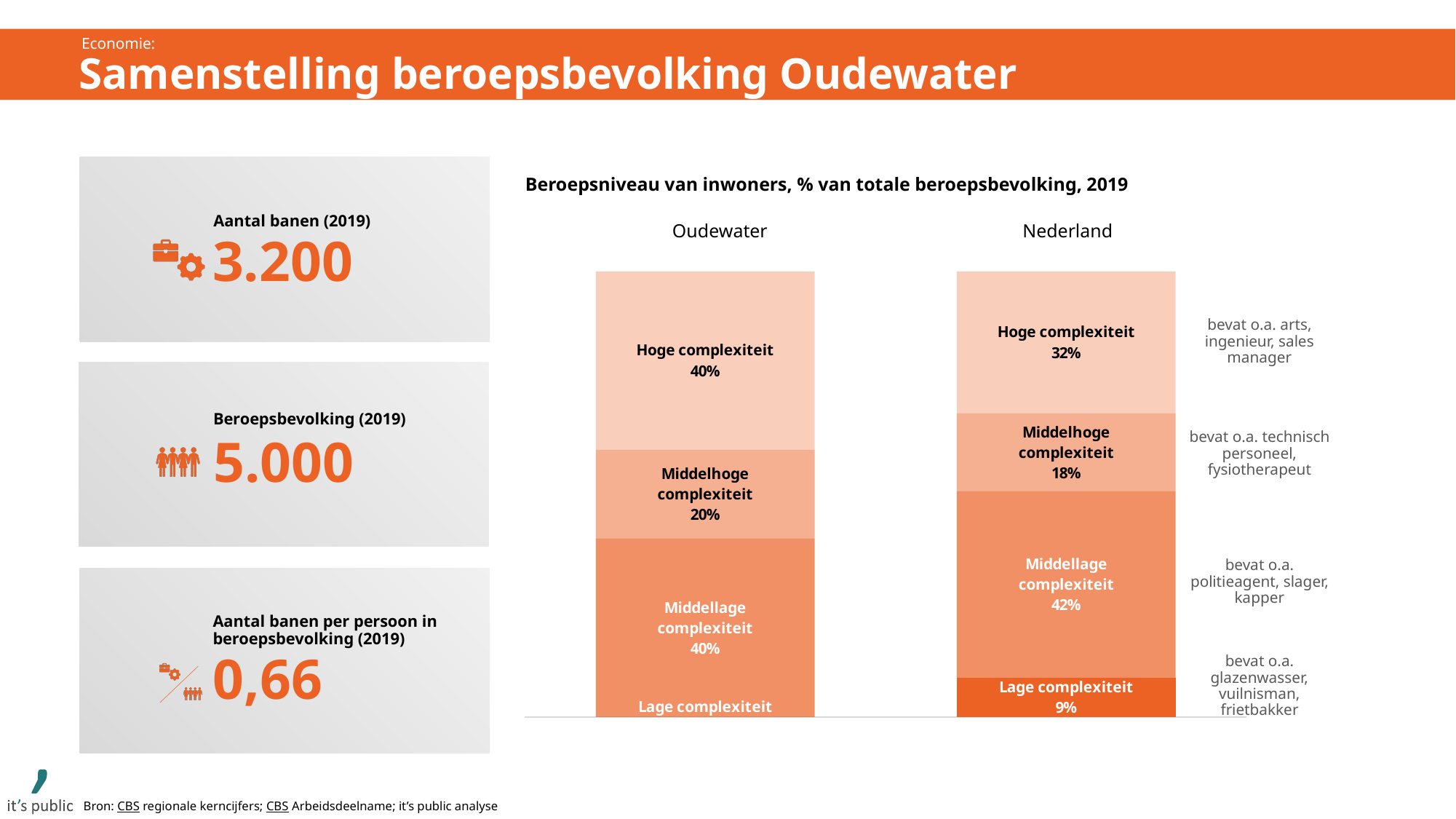
What kind of chart is shown under the title 'Beroepsniveau van inwoners, % van totale beroepsbevolking, 2019'? Stacked bar chart Which segment is the largest in the Nederland bar? Middellage complexiteit What is the share of 'Middellage complexiteit' for Oudewater? 40% How many bars are shown in the chart? 2 Which has a larger 'Middelhoge complexiteit' share, Oudewater or Nederland? Oudewater Which segment is the smallest in the Nederland bar? Lage complexiteit What is the share of 'Hoge complexiteit' for Oudewater? 40% What is the share of 'Lage complexiteit' for Nederland? 9% Which has a larger 'Middellage complexiteit' share, Oudewater or Nederland? Nederland What is the share of 'Middelhoge complexiteit' for Nederland? 18% Which two regions are compared in the chart? Oudewater and Nederland What is the difference between the 'Hoge complexiteit' share for Oudewater and for Nederland? 8 percentage points